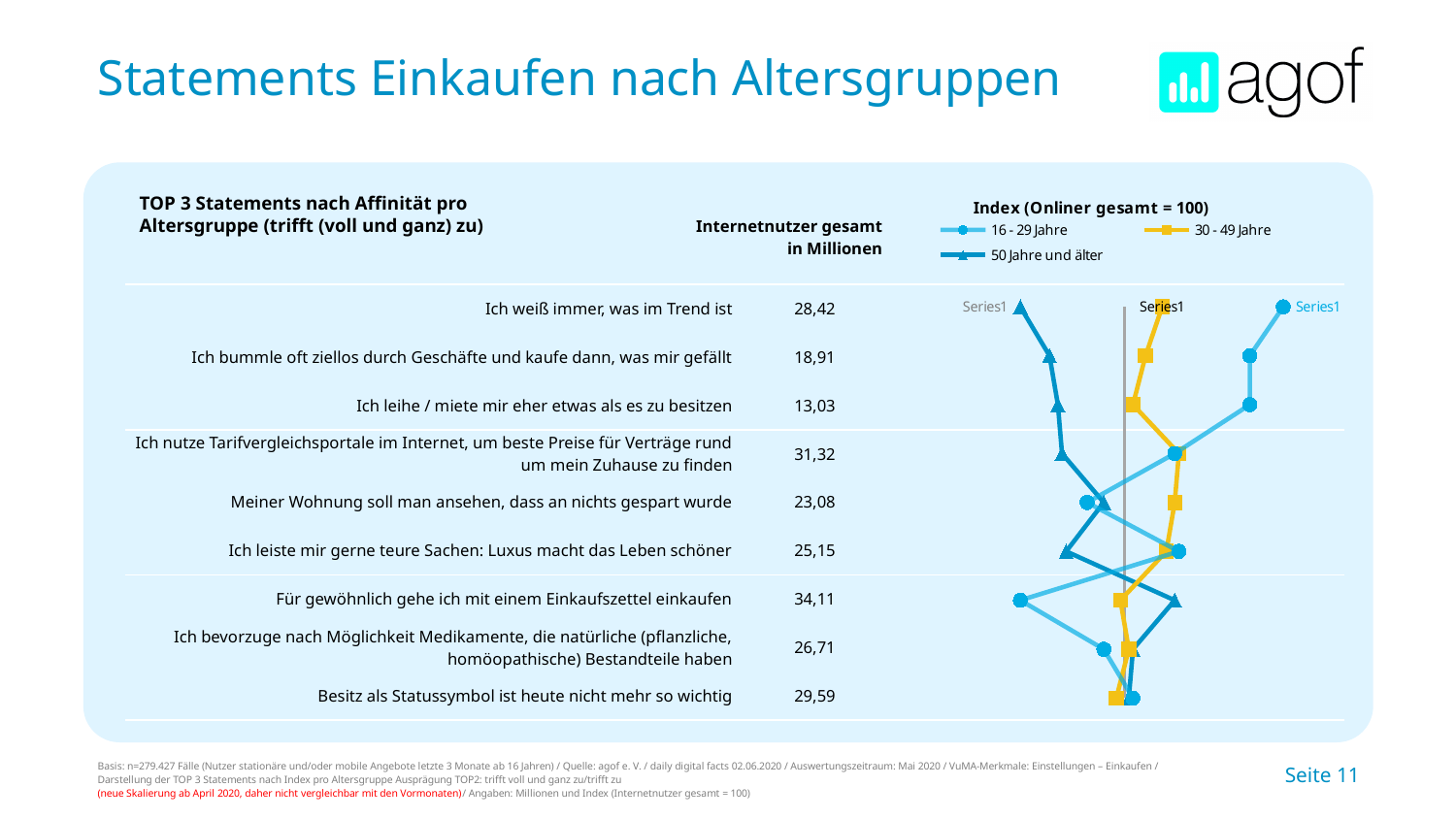
What is the difference in Millionen between 'Für gewöhnlich gehe ich mit einem Einkaufszettel einkaufen' and 'Ich leihe / miete mir eher etwas als es zu besitzen'? 21,08 How many series does the legend of the index chart list? 3 How many statements are plotted in the index chart? 9 Is the index for 50 Jahre und älter for 'Ich weiß immer, was im Trend ist' greater or less than 100? less What kind of chart is used to show the index values by age group? line chart Which age groups are listed in the legend of the index chart? 16 - 29 Jahre, 30 - 49 Jahre, 50 Jahre und älter Which statement has the lowest value in the 'Internetnutzer gesamt in Millionen' column? Ich leihe / miete mir eher etwas als es zu besitzen Is the index for 16 - 29 Jahre for 'Für gewöhnlich gehe ich mit einem Einkaufszettel einkaufen' greater or less than 100? less For 'Ich weiß immer, was im Trend ist', which age group has the higher index: 16 - 29 Jahre or 50 Jahre und älter? 16 - 29 Jahre For 'Für gewöhnlich gehe ich mit einem Einkaufszettel einkaufen', which age group has the higher index: 16 - 29 Jahre or 50 Jahre und älter? 50 Jahre und älter Is the index for 16 - 29 Jahre for 'Ich weiß immer, was im Trend ist' greater or less than 100? greater What is the value in Millionen for 'Für gewöhnlich gehe ich mit einem Einkaufszettel einkaufen'? 34,11